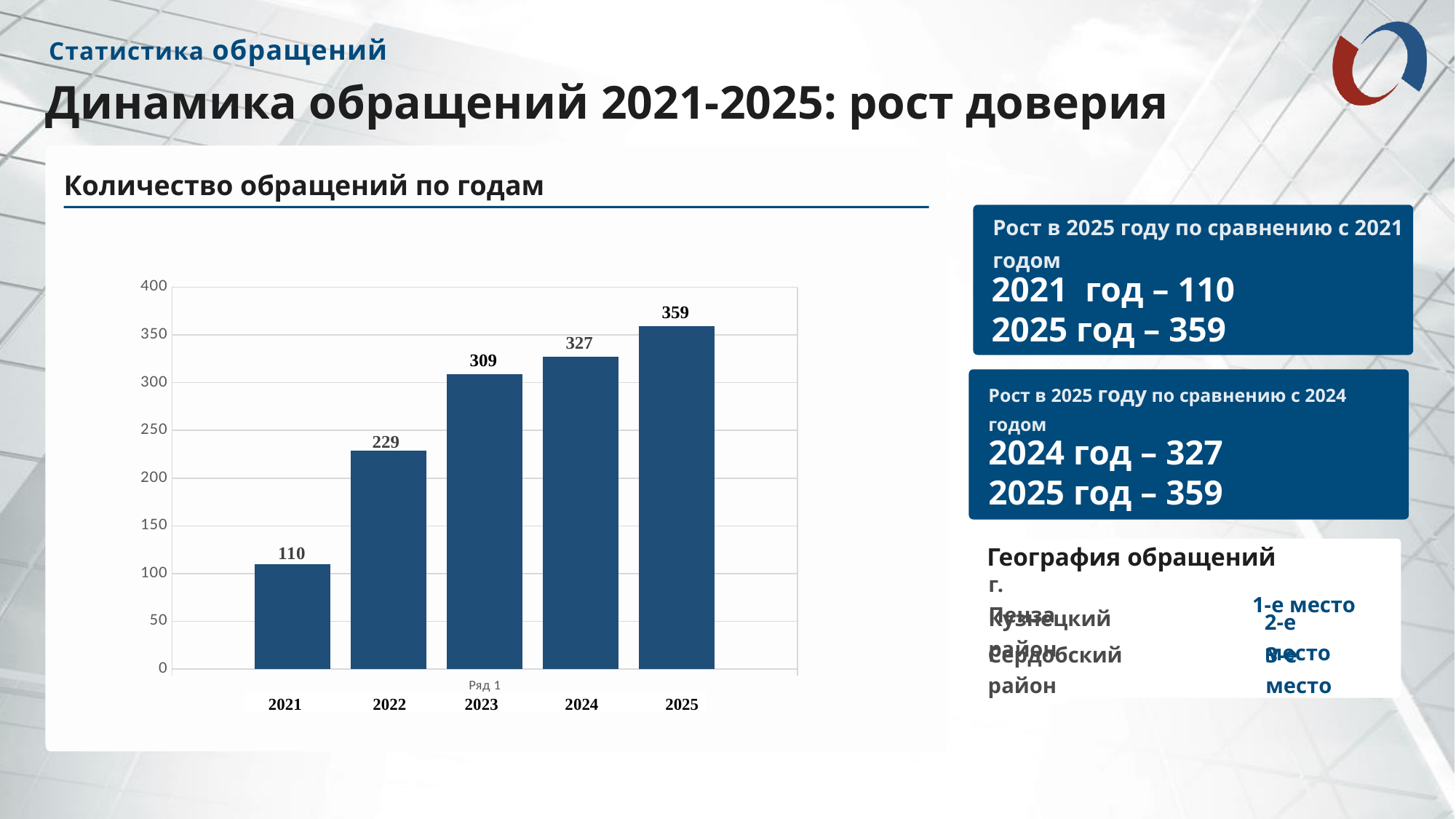
What is the value for 2025? 359 Which year has the lowest value? 2021 How many years are shown on the x axis? 5 What is the value for 2021? 110 Which is larger, the value for 2022 or the value for 2024? 2024 Is the value for 2022 greater or less than 250? less What is the value for 2023? 309 Do the values rise or fall from 2021 to 2025? rise Which year has the highest value? 2025 What is the difference between the values for 2025 and 2021? 249 What kind of chart is shown? bar chart What is the difference between the values for 2024 and 2023? 18